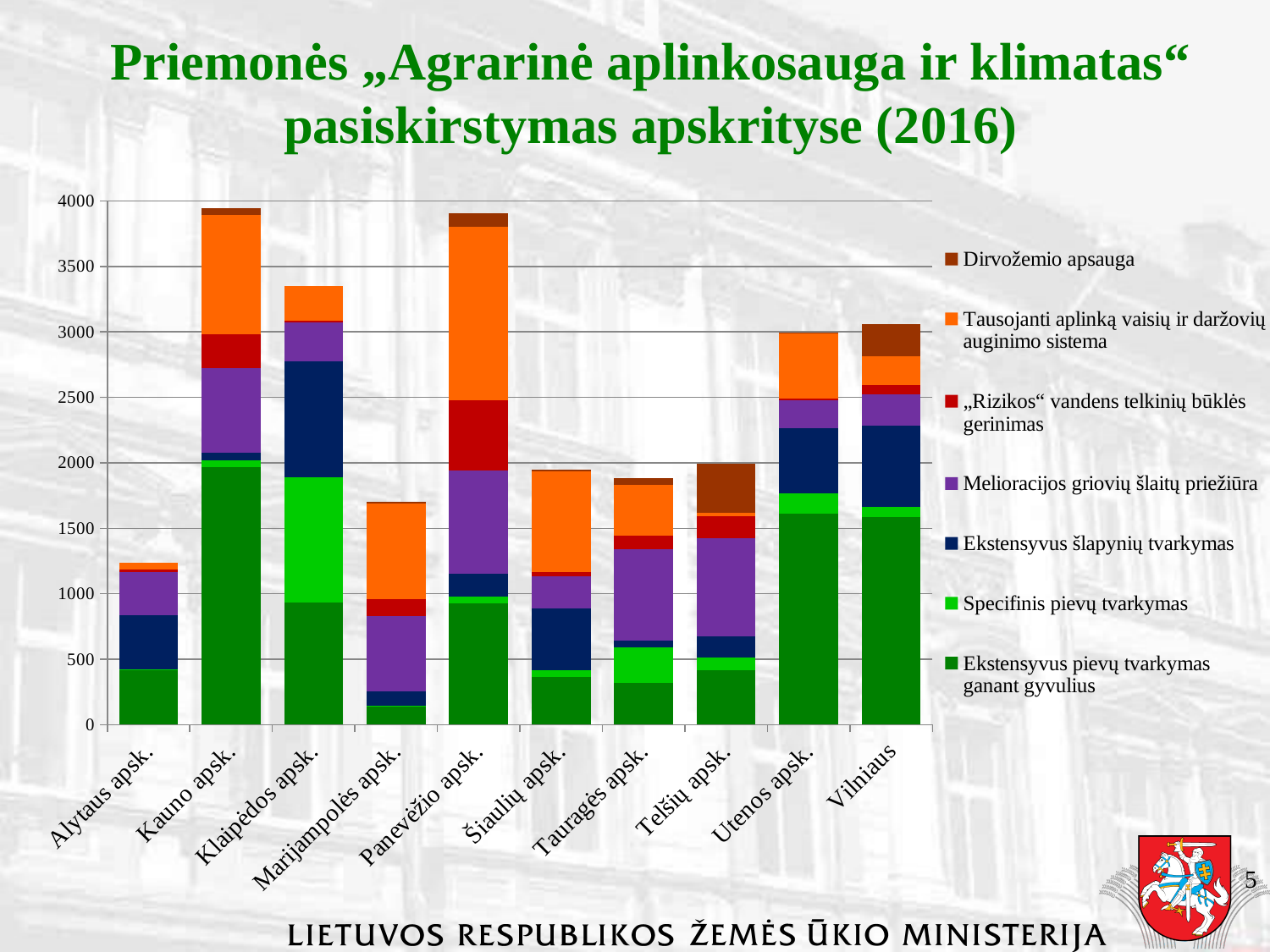
What kind of chart is shown on the slide? Stacked bar chart Is the total value for Alytaus apsk. greater or less than 1500? less How many counties (apskritys) are shown on the x axis of the chart? 10 How many series does the chart's legend list? 7 Which series is listed first (at the top) in the chart's legend? Dirvožemio apsauga Which county has the lowest total bar in the chart? Alytaus apsk. Is the total value for Marijampolės apsk. greater or less than 1500? greater Which has the larger total bar, Klaipėdos apsk. or Marijampolės apsk.? Klaipėdos apsk. Is the total value for Klaipėdos apsk. greater or less than 3000? greater What colour represents the series "Ekstensyvus pievų tvarkymas ganant gyvulius" in the chart? Dark green Which has the larger total bar, Kauno apsk. or Alytaus apsk.? Kauno apsk.